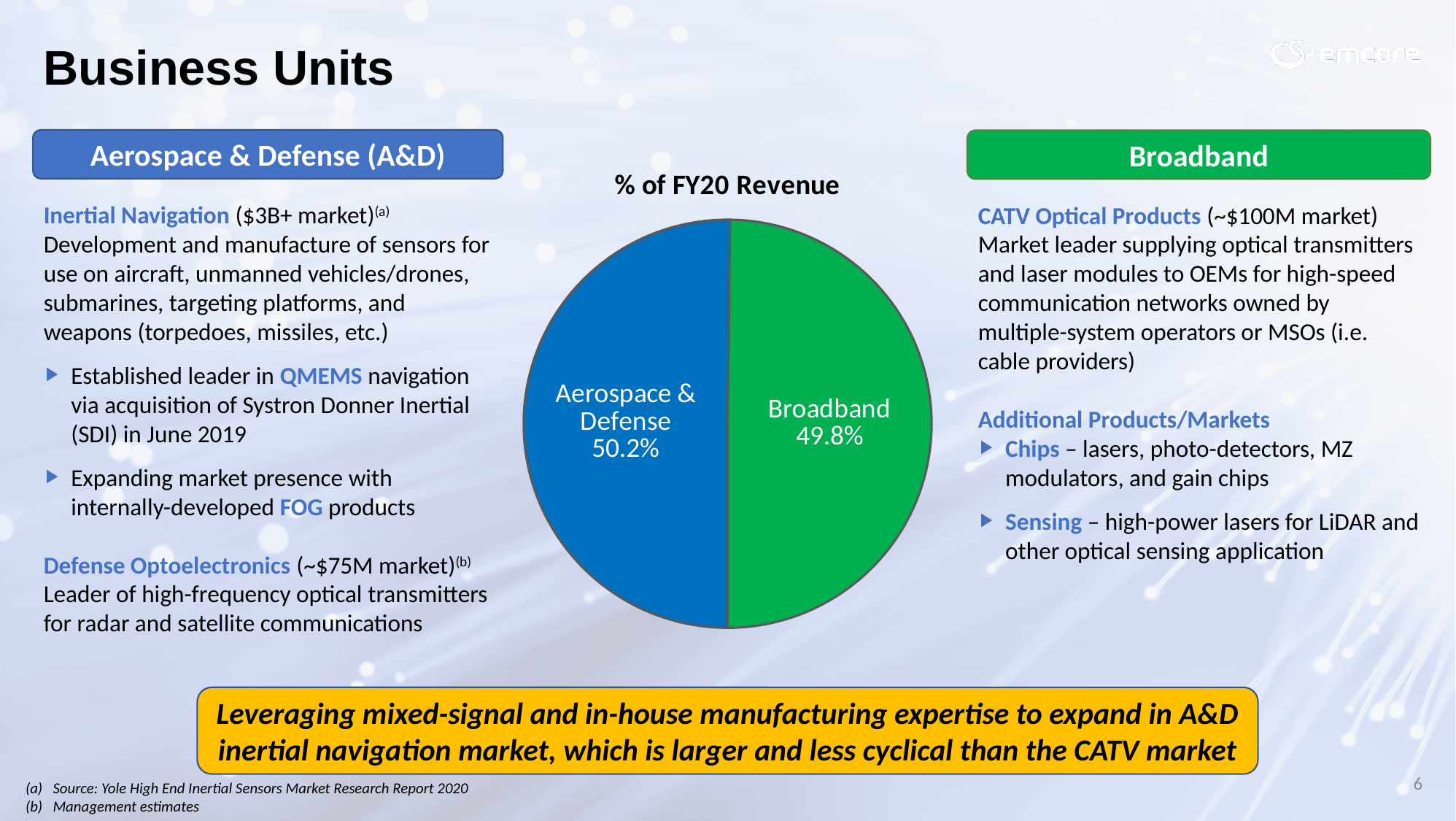
Which business unit has the smaller share of FY20 revenue in the pie chart? Broadband Is the Broadband share of FY20 revenue greater or less than 50%? less What share of FY20 revenue does the Aerospace & Defense slice represent in the pie chart? 50.2% What colour is the Broadband slice in the pie chart? green How many slices does the % of FY20 Revenue pie chart have? 2 What is the title of the pie chart on the slide? % of FY20 Revenue What is the difference in percentage points between the Aerospace & Defense and Broadband shares of FY20 revenue? 0.4 Is the Aerospace & Defense share of FY20 revenue larger or smaller than the Broadband share? larger What kind of chart is used to show the % of FY20 Revenue? pie chart Is the Aerospace & Defense share of FY20 revenue greater or less than 50%? greater What share of FY20 revenue does the Broadband slice represent in the pie chart? 49.8% Which business unit has the larger share of FY20 revenue in the pie chart? Aerospace & Defense